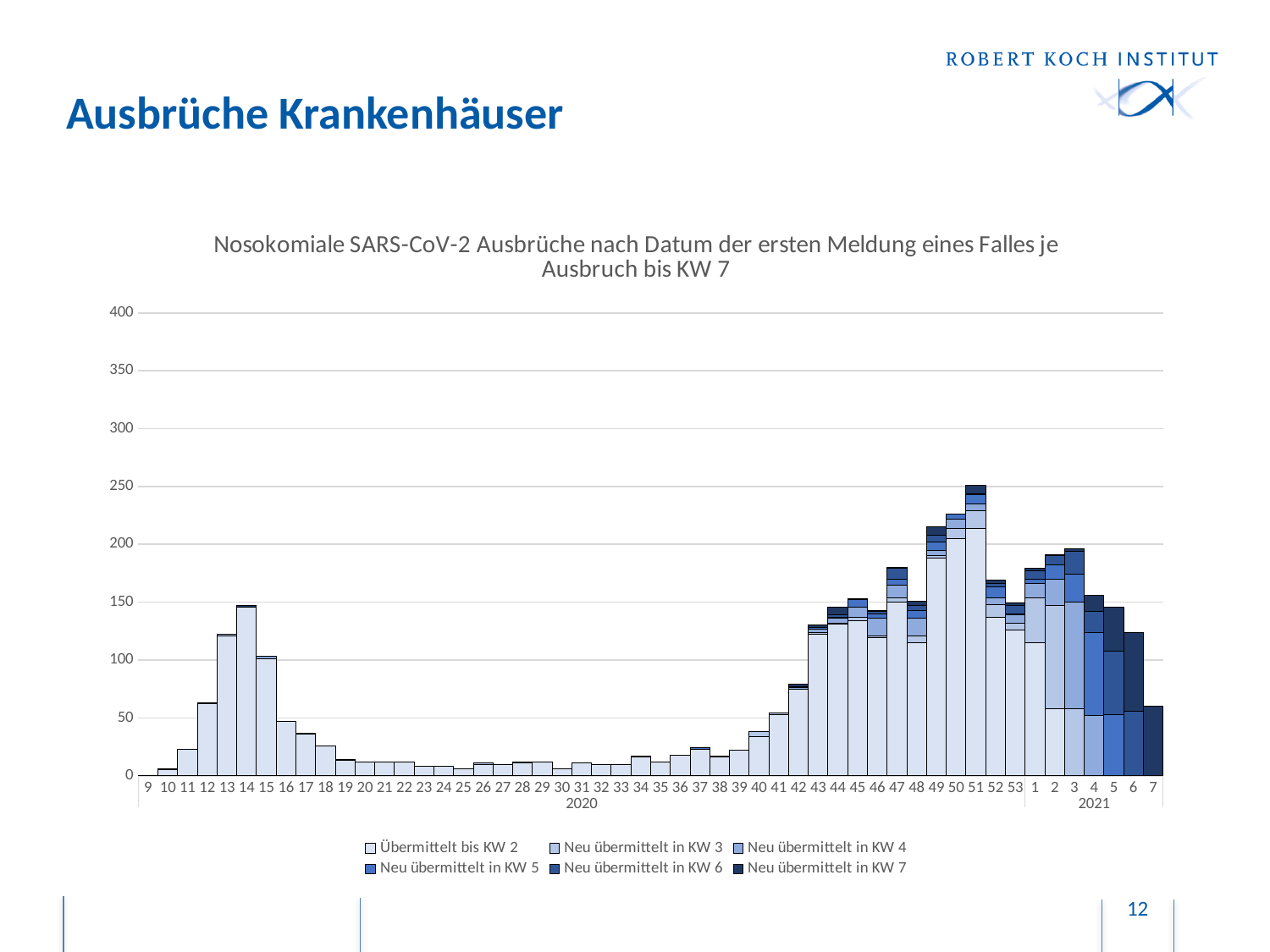
Is the total for KW 42 of 2020 greater or less than 100? less Which calendar week has the highest total number of outbreaks? KW 51 (2020) What kind of chart is shown on the slide? Stacked bar chart Is the total for KW 7 of 2021 greater or less than 50? greater Is the total for KW 51 of 2020 greater or less than 200? greater What is the title of the chart? Nosokomiale SARS-CoV-2 Ausbrüche nach Datum der ersten Meldung eines Falles je Ausbruch bis KW 7 Do the totals rise or fall from KW 39 to KW 51 of 2020? rise How many series does the legend list? 6 How many calendar weeks (bars) are plotted on the x axis? 52 What is the first series listed in the legend? Übermittelt bis KW 2 Which has the larger total, KW 14 of 2020 or KW 15 of 2020? KW 14 of 2020